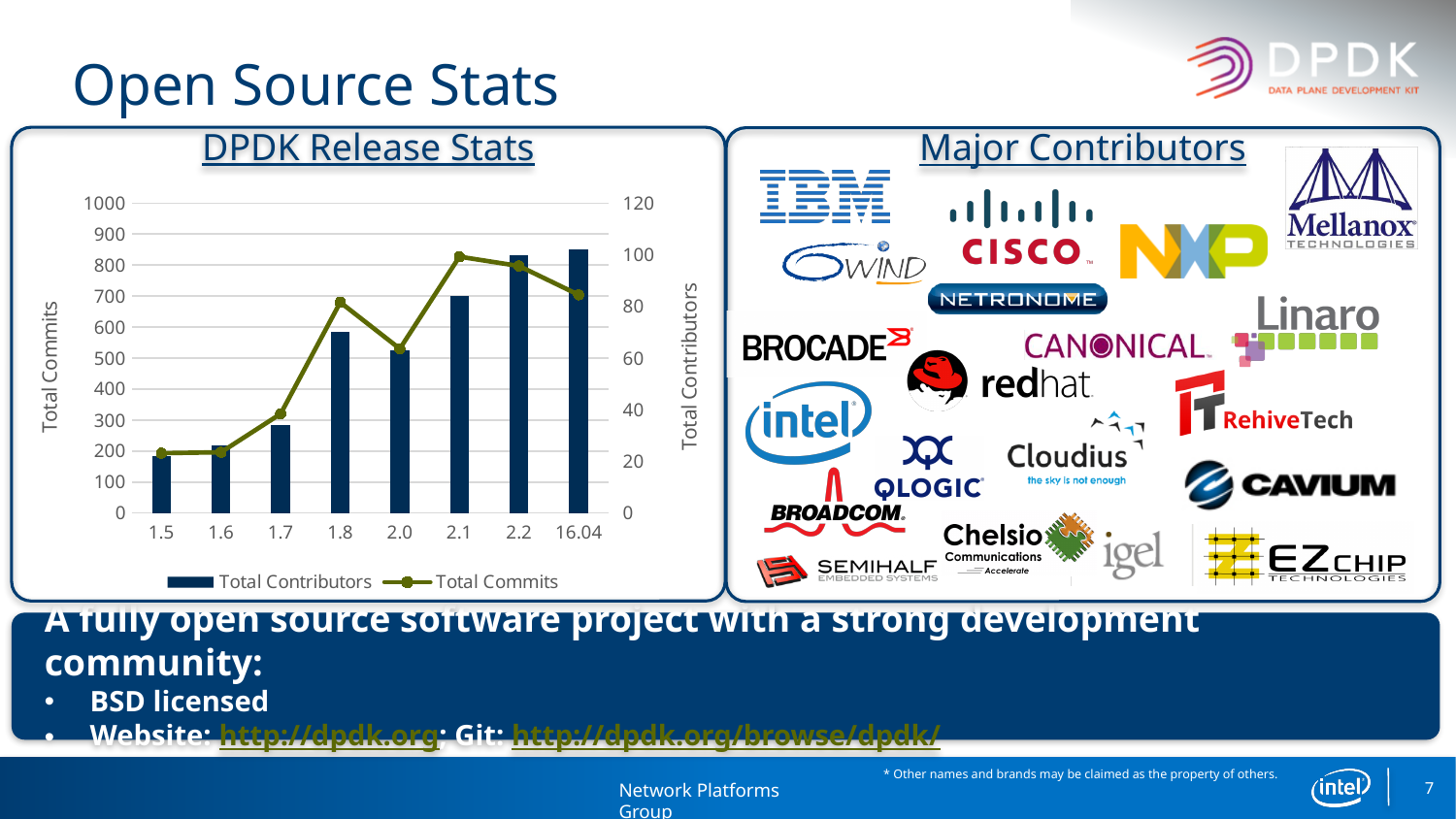
In the DPDK Release Stats chart, is the Total Commits value for release 2.0 greater or less than 600? less In the DPDK Release Stats chart, is the Total Contributors value for release 2.2 greater or less than 80? greater In the DPDK Release Stats chart, which series is drawn as a line? Total Commits In the DPDK Release Stats chart, how many series does the legend list? 2 In the DPDK Release Stats chart, do Total Commits rise or fall from release 1.5 to release 1.8? rise In the DPDK Release Stats chart, is the Total Contributors value for release 1.7 greater or less than 40? less In the DPDK Release Stats chart, which release has more Total Commits, 2.0 or 2.1? 2.1 In the DPDK Release Stats chart, which release has more Total Contributors, 1.8 or 2.0? 1.8 What kind of chart is the DPDK Release Stats chart? Combined bar and line chart What is the title of the chart on the left of the slide? DPDK Release Stats In the DPDK Release Stats chart, how many release versions are shown on the x axis? 8